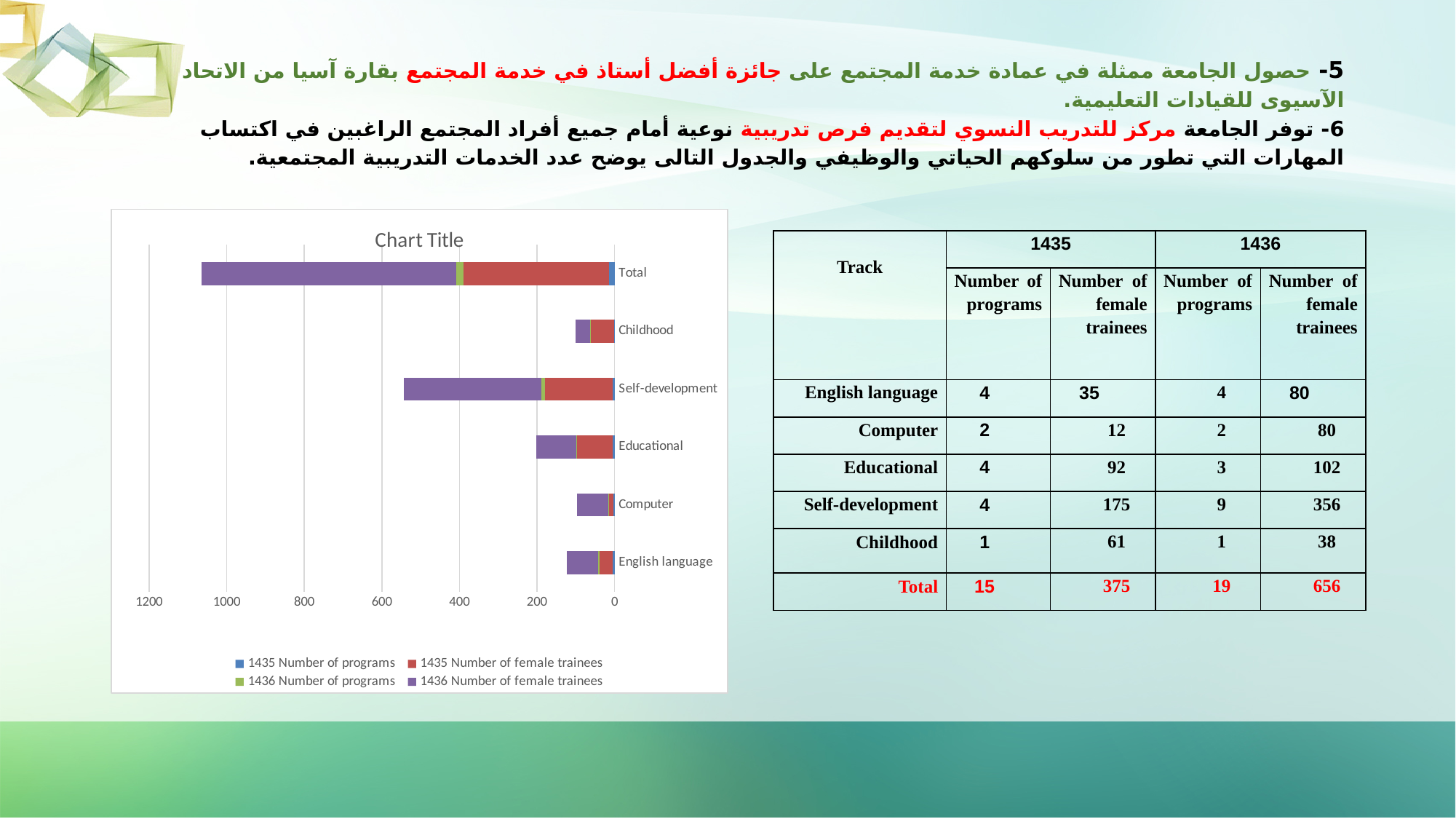
Which category has the longest stacked bar in the chart? Total Is the total length of the stacked bar for Total greater or less than 1000? greater Is the total length of the stacked bar for Childhood greater or less than 200? less How many categories are plotted on the chart's vertical axis? 6 What kind of chart is shown on the slide? bar chart According to the table, what is the 1436 Number of female trainees for Self-development? 356 Excluding the Total bar, which track has the longest stacked bar in the chart? Self-development Using the values in the table, what is the total of the stacked bar for Total (sum of all four series)? 1065 How many series does the chart legend list? 4 Which stacked bar is longer, Self-development or Educational? Self-development What is the title shown above the chart? Chart Title Is the total length of the stacked bar for Self-development greater or less than 400? greater